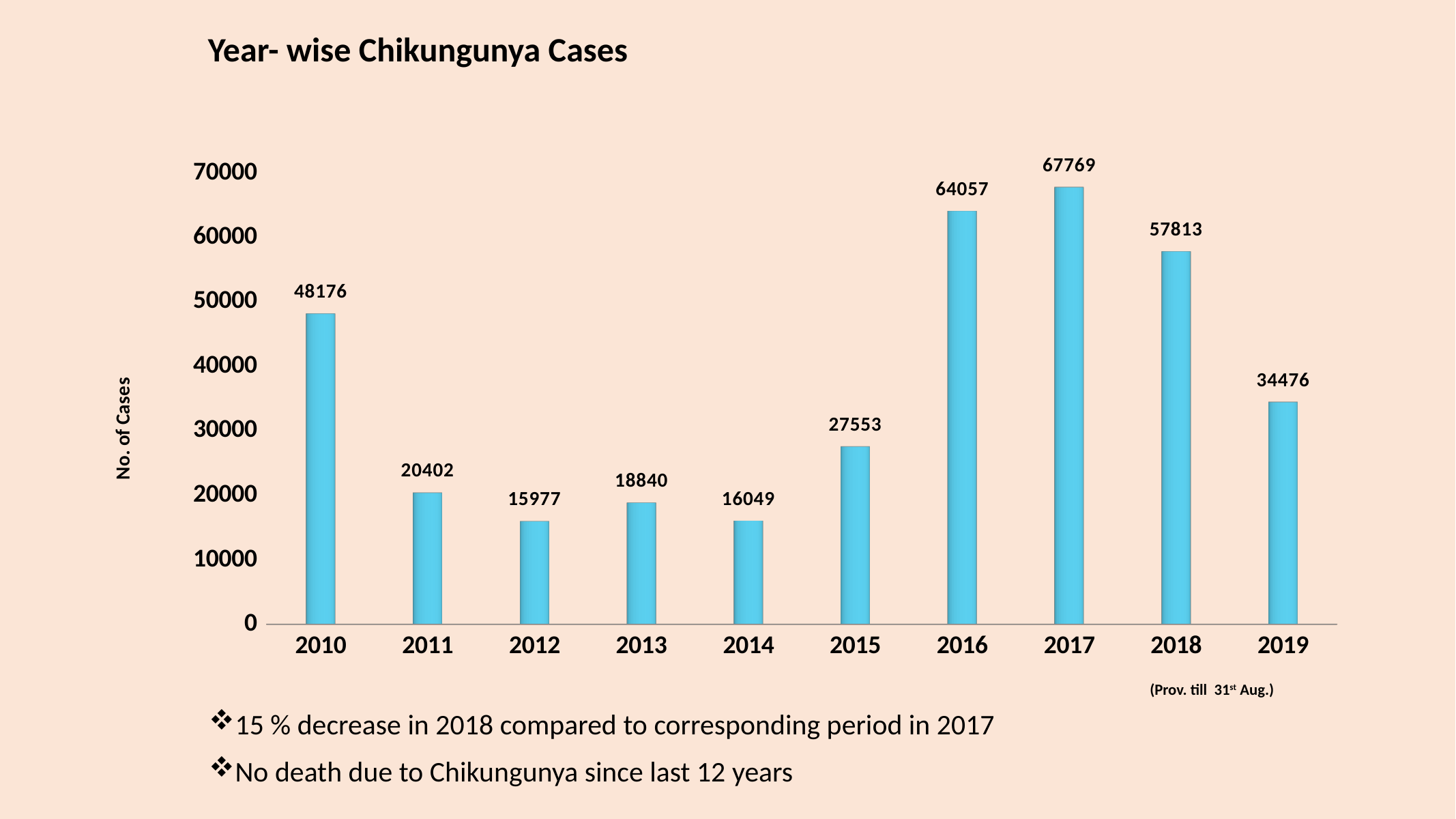
What is the difference in cases between 2017 and 2018? 9956 What is the number of Chikungunya cases in 2016? 64057 Is the value for 2015 greater or less than 30000? less Which year has the highest number of Chikungunya cases? 2017 How many years are shown on the x axis? 10 Which year had more cases, 2010 or 2018? 2018 What is the difference in cases between 2016 and 2015? 36504 What kind of chart is shown on the slide? bar chart What is the number of Chikungunya cases in 2019? 34476 What is the number of Chikungunya cases in 2012? 15977 Which year has the lowest number of Chikungunya cases? 2012 What is the title of the chart? Year- wise Chikungunya Cases